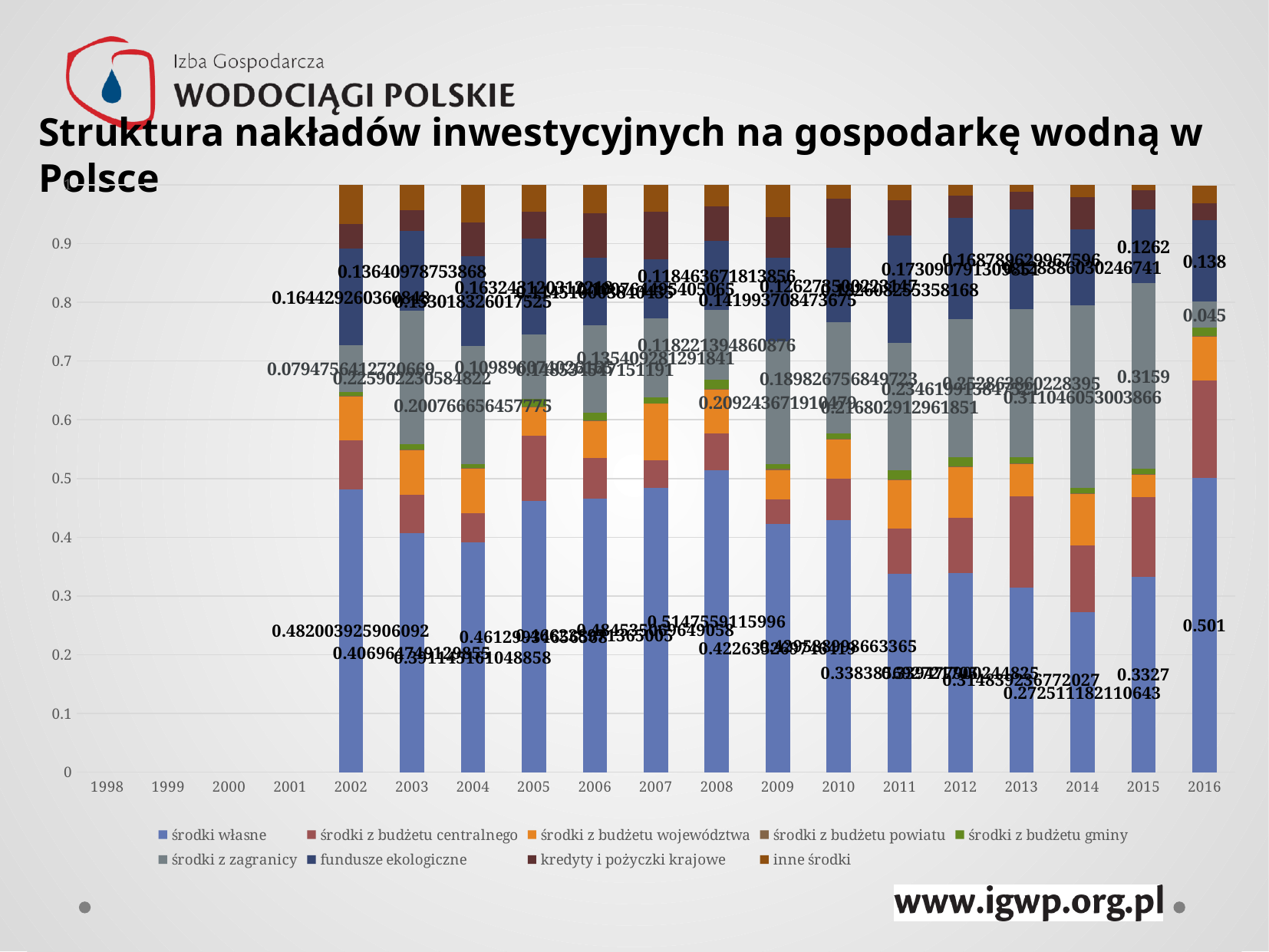
How many years have bars plotted in the chart? 15 What kind of chart is shown on the slide? stacked bar chart Is the value for środki własne in 2013 greater or less than 0.4? less What is the value of środki własne for 2016? 0.501 Which year has the lowest value for środki własne? 2014 Which is larger, the środki własne value for 2016 or for 2014? 2016 What is the value of środki własne for 2014? 0.272511182110643 What is the title of the chart? Struktura nakładów inwestycyjnych na gospodarkę wodną w Polsce How many series does the legend list? 9 What is the value of środki własne for 2002? 0.482003925906092 What is the difference between the środki własne values for 2016 and 2015? 0.1683 What is the value of środki własne for 2015? 0.3327